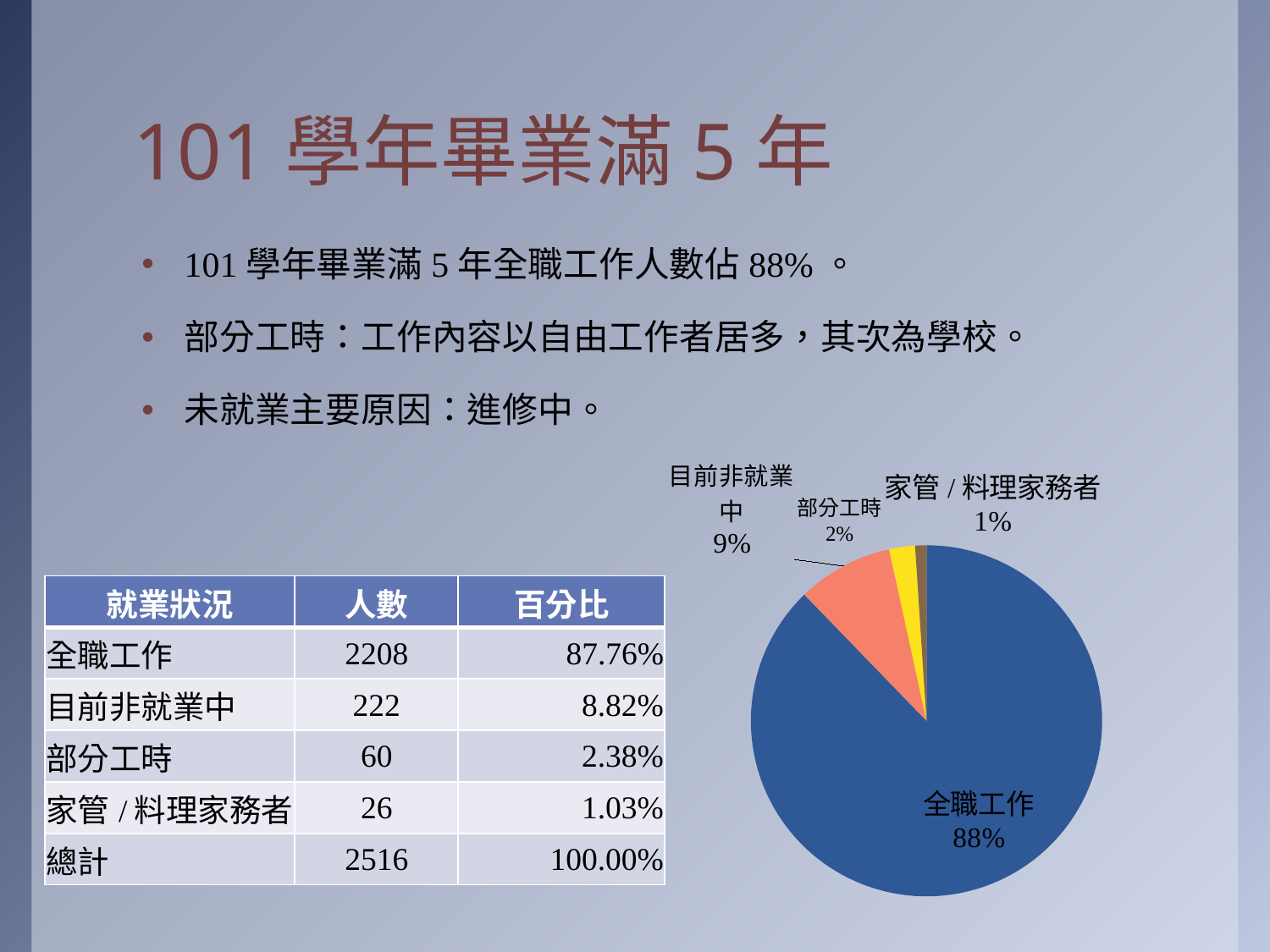
Which slice of the pie chart is the smallest? 家管 / 料理家務者 What kind of chart is shown on the slide? pie chart In the pie chart, what is the difference in percentage points between the 部分工時 slice and the 家管 / 料理家務者 slice? 1 In the pie chart, what share is labelled for 目前非就業中? 9% In the pie chart, what is the difference in percentage points between the 全職工作 slice and the 目前非就業中 slice? 79 In the pie chart, which is larger: the slice for 目前非就業中 or the slice for 部分工時? 目前非就業中 What colour is the 全職工作 slice in the pie chart? blue Which slice of the pie chart is the largest? 全職工作 In the pie chart, what share is labelled for 全職工作? 88% How many slices does the pie chart have? 4 In the pie chart, what share is labelled for 家管 / 料理家務者? 1% In the pie chart, what share is labelled for 部分工時? 2%